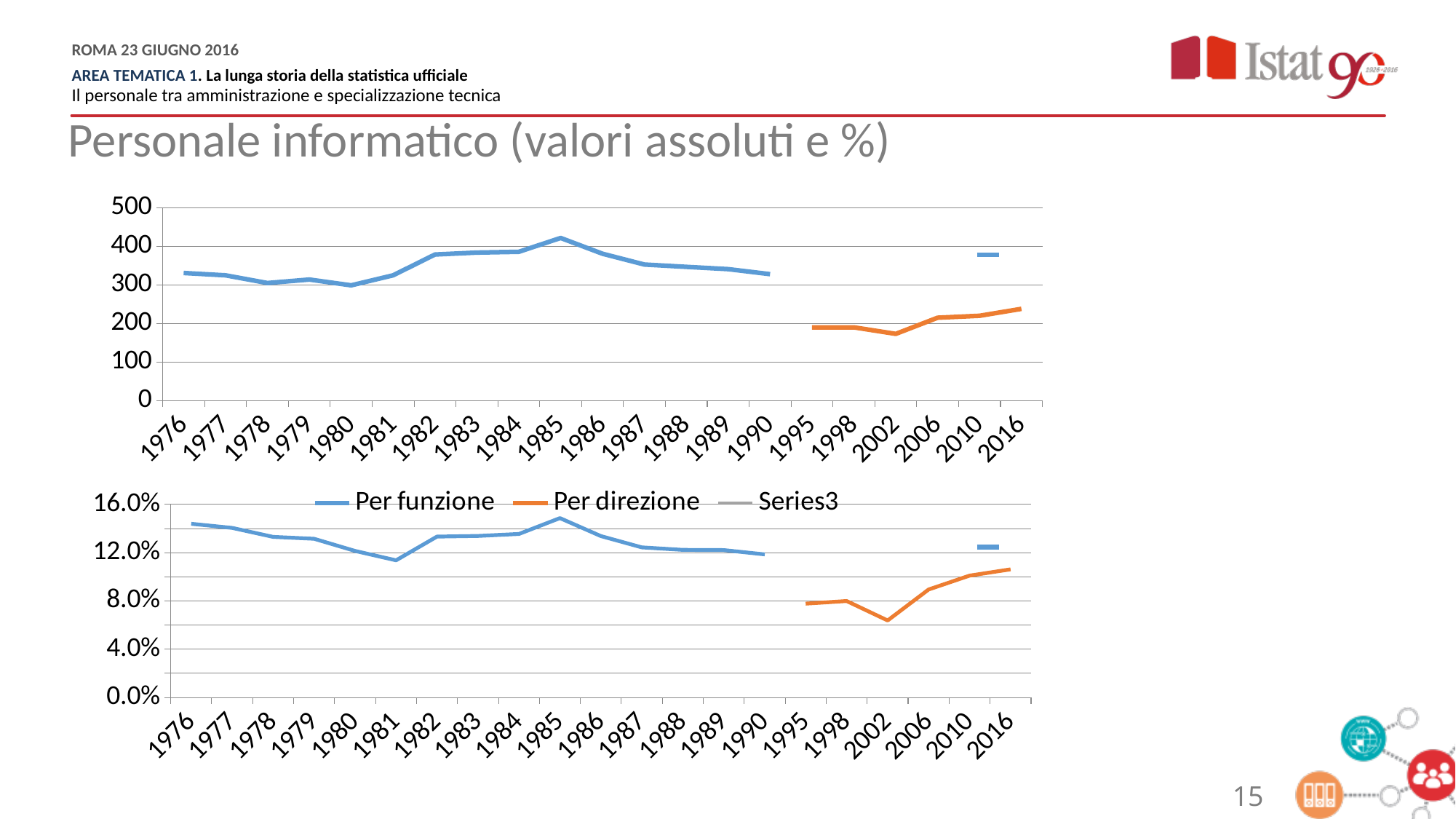
What colour is the Per direzione series line? orange In the top chart, in which year does the Per direzione series reach its lowest value? 2002 In the top chart, in which year does the Per funzione series reach its highest value? 1985 In the bottom chart, in which year does the Per funzione series reach its lowest value? 1981 In the bottom chart, is the Per direzione value for 2002 greater or less than 8.0%? less What type of chart is the top chart on the slide? line chart In the top chart, which is larger: the Per funzione value for 1985 or the Per direzione value for 2016? Per funzione value for 1985 In the bottom chart, does the Per direzione series rise or fall from 2002 to 2016? rise In the top chart, is the Per direzione value for 2002 greater or less than 200? less How many series does the legend list? 3 In the top chart, is the Per funzione value for 1985 greater or less than 400? greater How many year categories are shown on the x axis of the top chart? 21